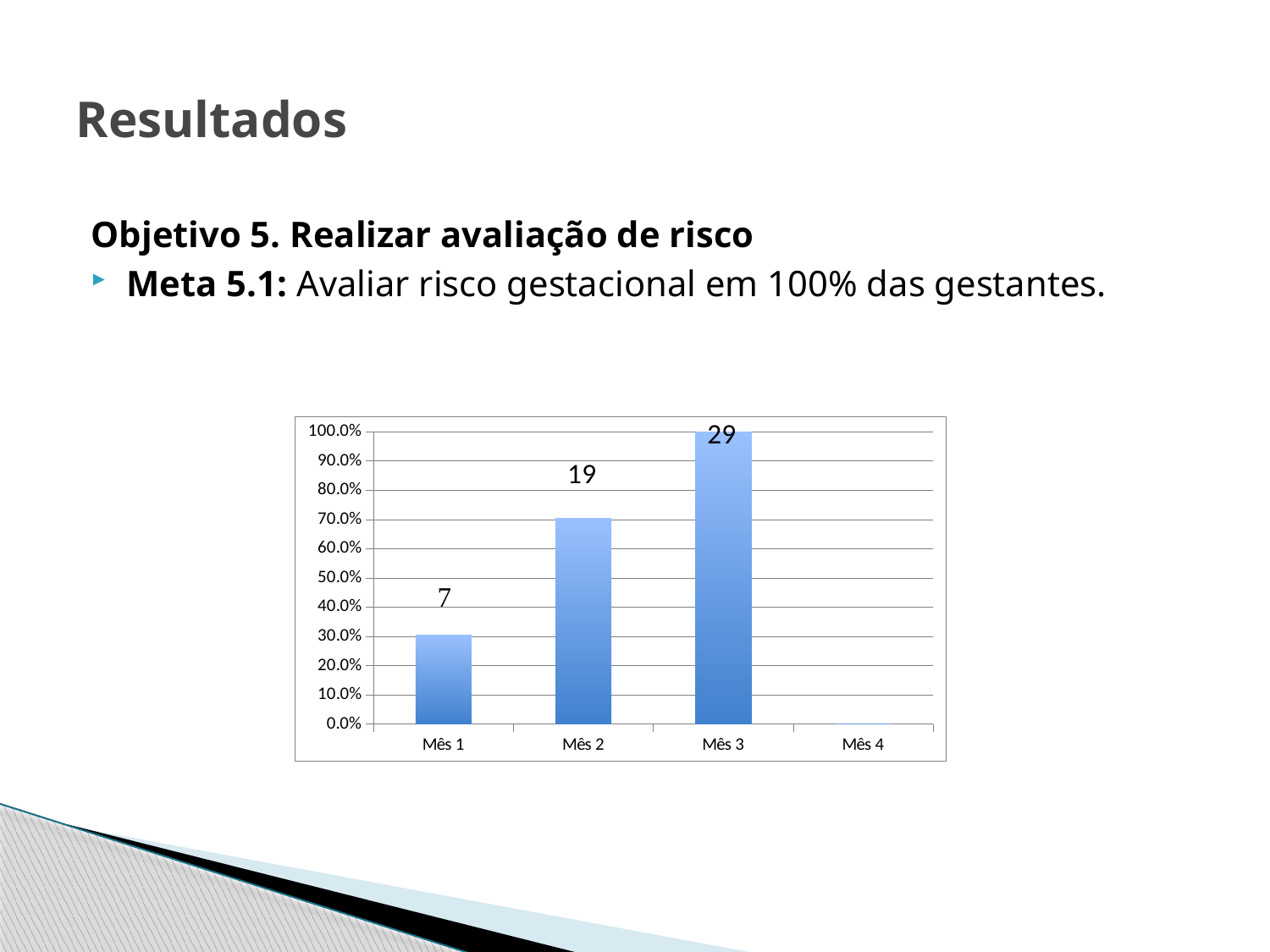
Among the months with a bar, which has the shortest bar? Mês 1 What is the difference between the data labels for Mês 3 and Mês 1? 22 Is the bar for Mês 1 greater or less than 40.0% on the axis? less What kind of chart is shown on the slide? bar chart How many month categories are shown on the x axis? 4 Which bar is taller, Mês 2 or Mês 1? Mês 2 Which month has the tallest bar? Mês 3 What is the data label shown on the bar for Mês 3? 29 What is the data label shown on the bar for Mês 2? 19 Is the bar for Mês 2 greater or less than 60.0% on the axis? greater What is the difference between the data labels for Mês 2 and Mês 1? 12 What is the data label shown on the bar for Mês 1? 7